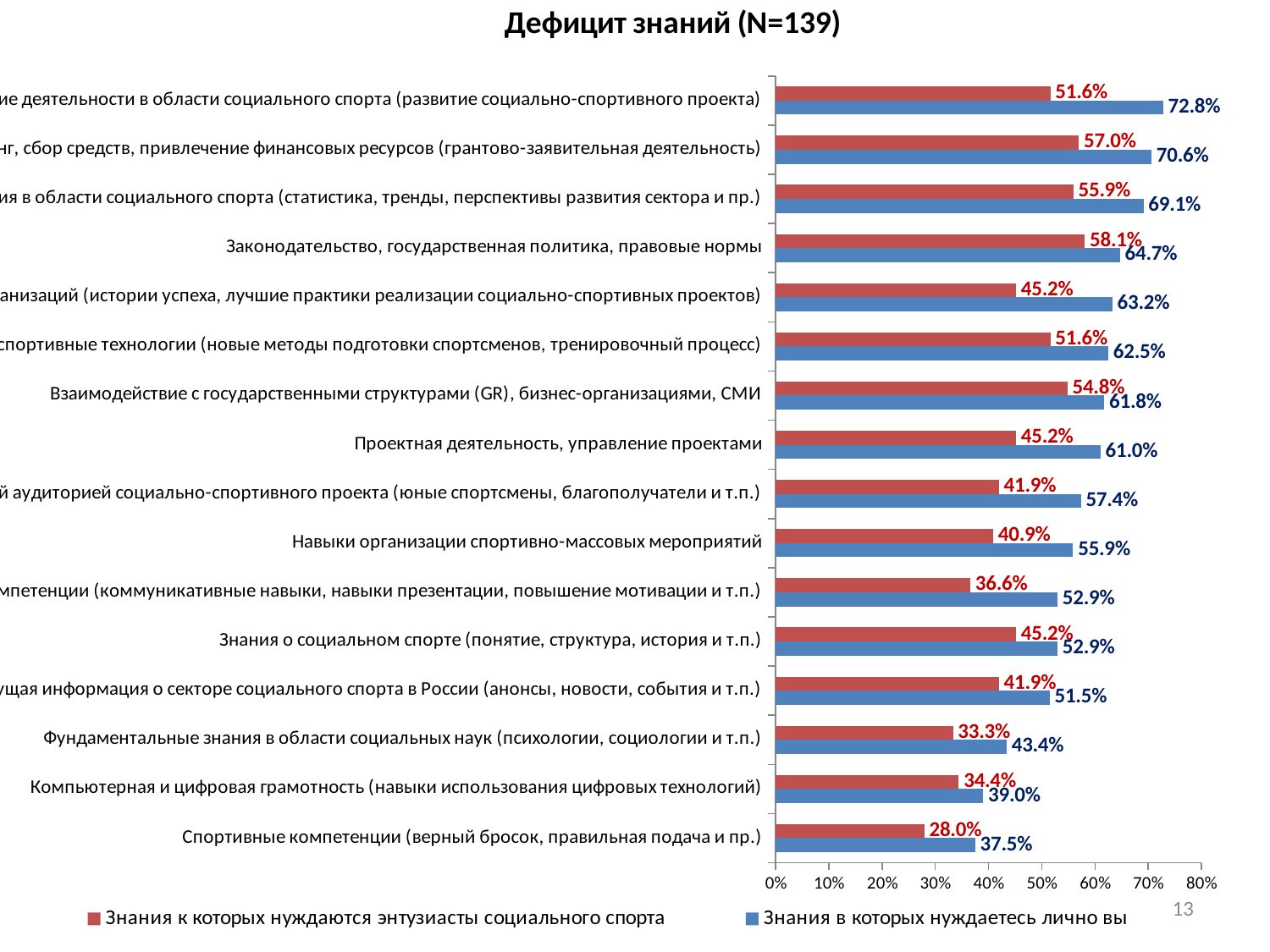
What is the title of the chart? Дефицит знаний (N=139) What is the value for 'Законодательство, государственная политика, правовые нормы' in the series 'Знания в которых нуждаетесь лично вы'? 64.7% What is the difference between the two series for 'Навыки организации спортивно-массовых мероприятий'? 15.0% Is the value for 'Фундаментальные знания в области социальных наук (психологии, социологии и т.п.)' in the series 'Знания в которых нуждаетесь лично вы' greater or less than 40%? greater How many categories are shown in the chart? 16 Which category has the lowest value in the series 'Знания в которых нуждаетесь лично вы'? Спортивные компетенции (верный бросок, правильная подача и пр.) How many series does the legend list? 2 Which category has the highest value in the series 'Знания к которых нуждаются энтузиасты социального спорта'? Законодательство, государственная политика, правовые нормы What is the value for 'Проектная деятельность, управление проектами' in the series 'Знания в которых нуждаетесь лично вы'? 61.0% What kind of chart is shown on the slide? bar chart For 'Компьютерная и цифровая грамотность (навыки использования цифровых технологий)', which series has the larger value? Знания в которых нуждаетесь лично вы What is the value for 'Спортивные компетенции (верный бросок, правильная подача и пр.)' in the series 'Знания к которых нуждаются энтузиасты социального спорта'? 28.0%